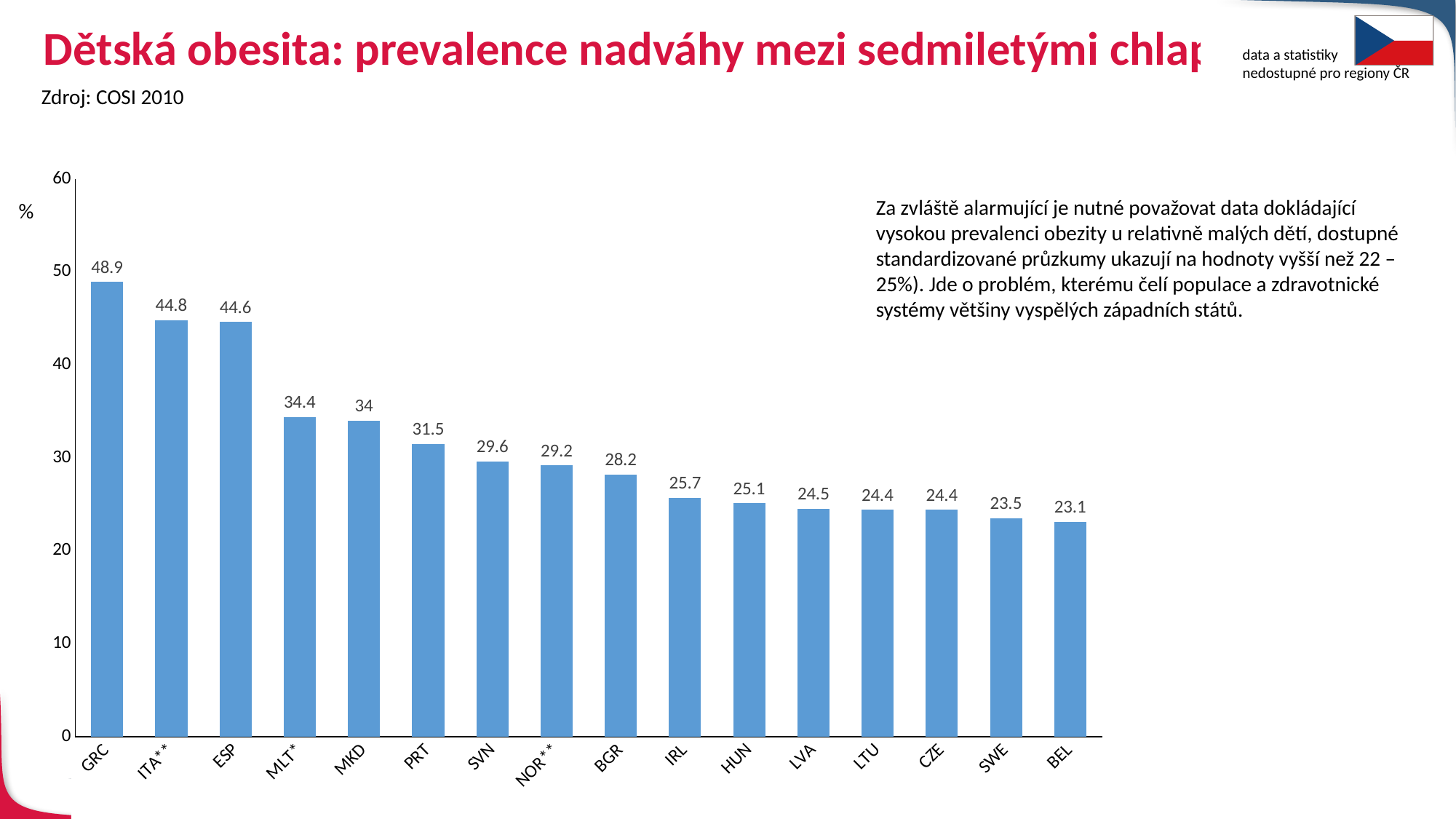
Which country has the lowest value? BEL What kind of chart is shown on the slide? bar chart Do the values rise or fall from left to right along the x axis? fall How many countries are shown on the chart? 16 Which country has the highest value? GRC What is the value for GRC? 48.9 Which is larger, the value for ESP or the value for SVN? ESP What is the value for PRT? 31.5 What is the difference between the values for GRC and BEL? 25.8 What is the value for CZE? 24.4 What is the difference between the values for MLT* and MKD? 0.4 Is the value for IRL greater or less than 30? less